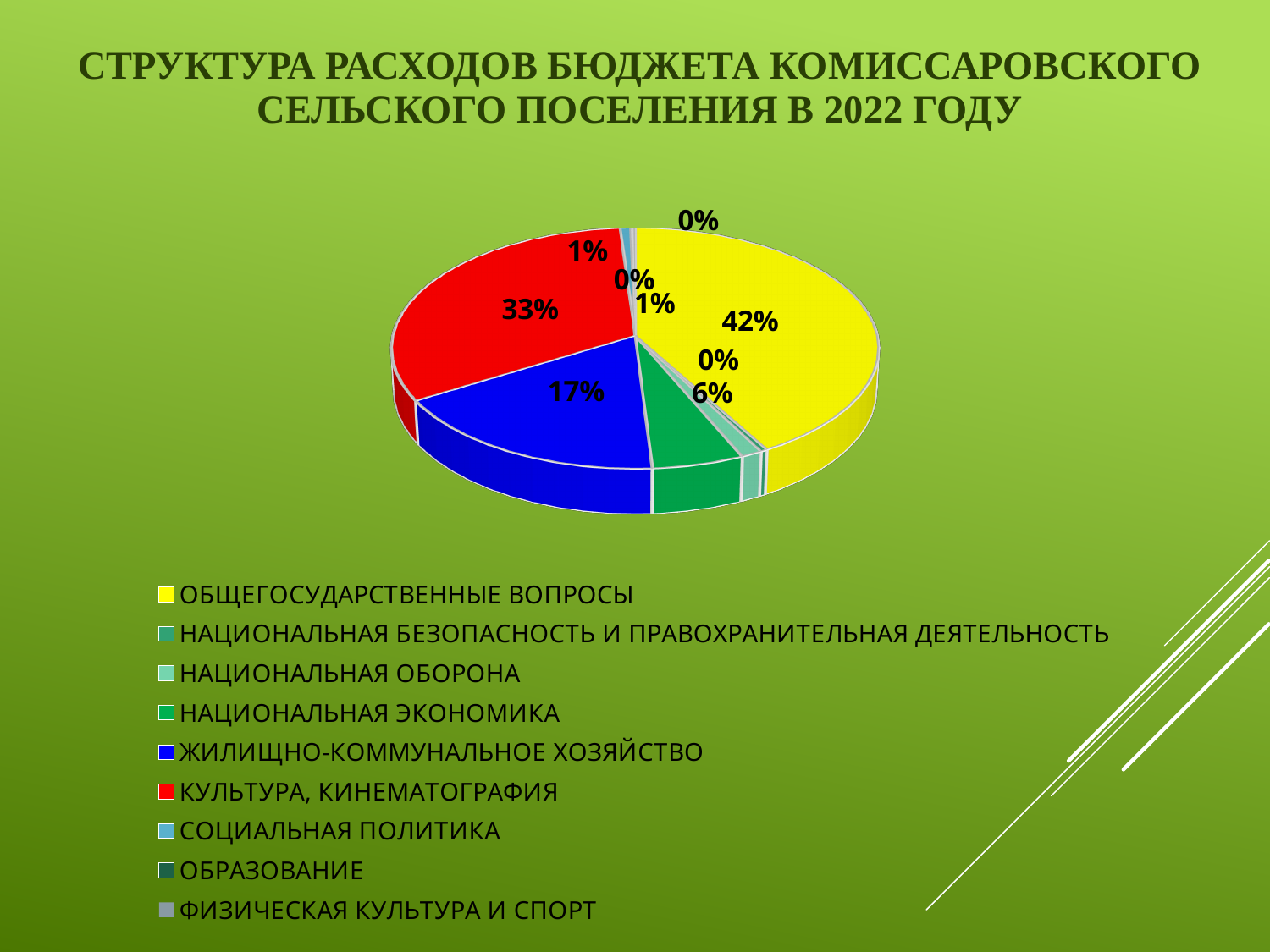
By how many percentage points does ОБЩЕГОСУДАРСТВЕННЫЕ ВОПРОСЫ exceed КУЛЬТУРА, КИНЕМАТОГРАФИЯ? 9 percentage points What share of the pie does КУЛЬТУРА, КИНЕМАТОГРАФИЯ represent? 33% What kind of chart is shown on the slide? Pie chart What is the combined share of ОБЩЕГОСУДАРСТВЕННЫЕ ВОПРОСЫ, КУЛЬТУРА, КИНЕМАТОГРАФИЯ and ЖИЛИЩНО-КОММУНАЛЬНОЕ ХОЗЯЙСТВО? 92% How many categories does the legend list? 9 Which colour represents ЖИЛИЩНО-КОММУНАЛЬНОЕ ХОЗЯЙСТВО in the chart? Blue Which category has the largest share of the pie? ОБЩЕГОСУДАРСТВЕННЫЕ ВОПРОСЫ What is the value shown for НАЦИОНАЛЬНАЯ ЭКОНОМИКА? 6% What is the value shown for ЖИЛИЩНО-КОММУНАЛЬНОЕ ХОЗЯЙСТВО? 17% Which is larger: the share for КУЛЬТУРА, КИНЕМАТОГРАФИЯ or the share for ЖИЛИЩНО-КОММУНАЛЬНОЕ ХОЗЯЙСТВО? КУЛЬТУРА, КИНЕМАТОГРАФИЯ What share of the pie does ОБЩЕГОСУДАРСТВЕННЫЕ ВОПРОСЫ represent? 42% By how many percentage points does ЖИЛИЩНО-КОММУНАЛЬНОЕ ХОЗЯЙСТВО exceed НАЦИОНАЛЬНАЯ ЭКОНОМИКА? 11 percentage points